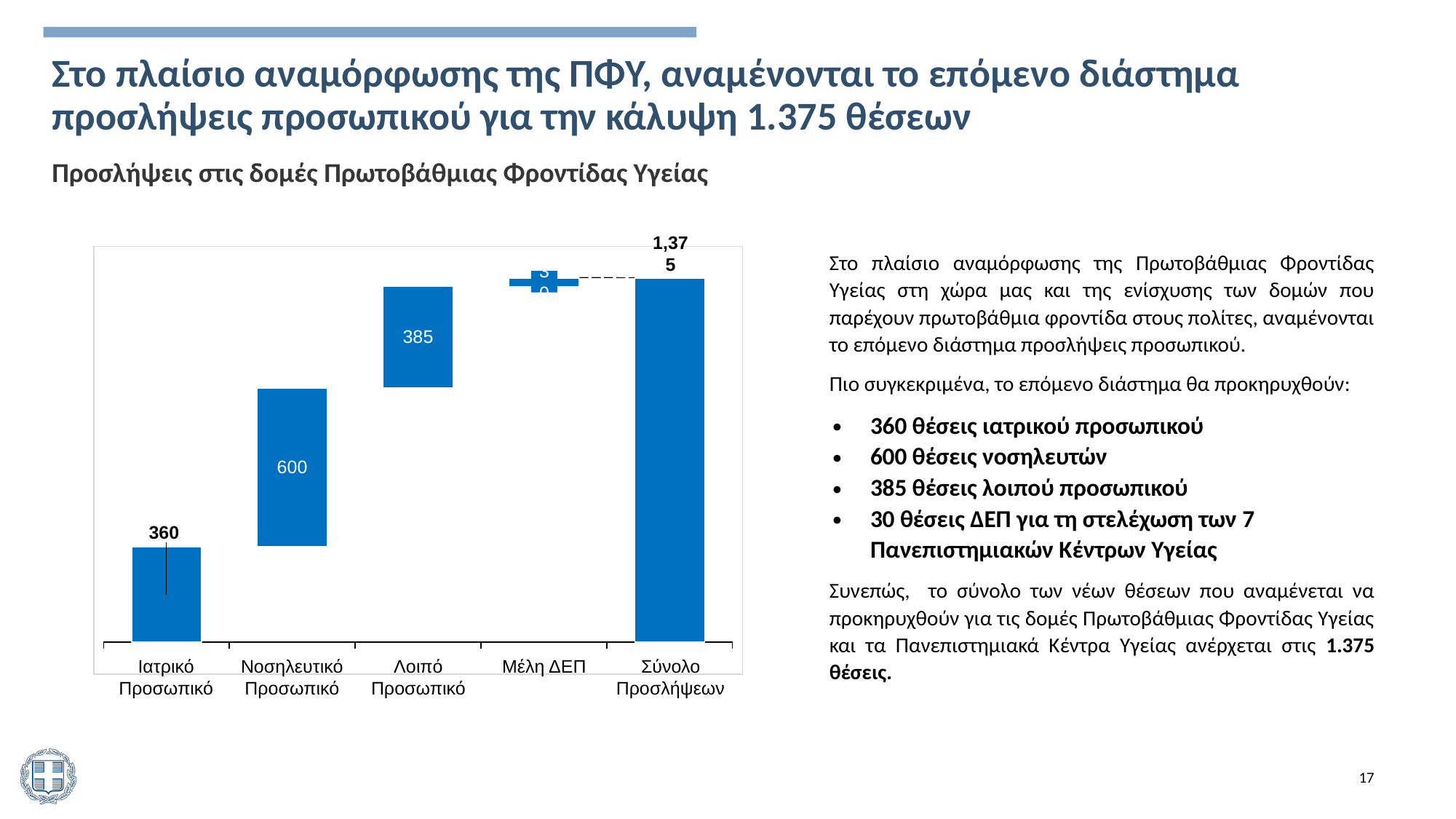
What is the title of the chart? Προσλήψεις στις δομές Πρωτοβάθμιας Φροντίδας Υγείας Excluding the Σύνολο Προσλήψεων bar, which category has the highest value? Νοσηλευτικό Προσωπικό What is the value for Νοσηλευτικό Προσωπικό? 600 What is the difference between the values for Νοσηλευτικό Προσωπικό and Λοιπό Προσωπικό? 215 What is the value for Ιατρικό Προσωπικό? 360 What kind of chart is shown on the slide? bar chart Which is larger, the value for Ιατρικό Προσωπικό or the value for Λοιπό Προσωπικό? Λοιπό Προσωπικό What is the value for Λοιπό Προσωπικό? 385 What is the value shown for Σύνολο Προσλήψεων? 1,375 How many categories are shown on the x axis of the chart? 5 Which category has the lowest value? Μέλη ΔΕΠ What is the difference between the values for Νοσηλευτικό Προσωπικό and Ιατρικό Προσωπικό? 240